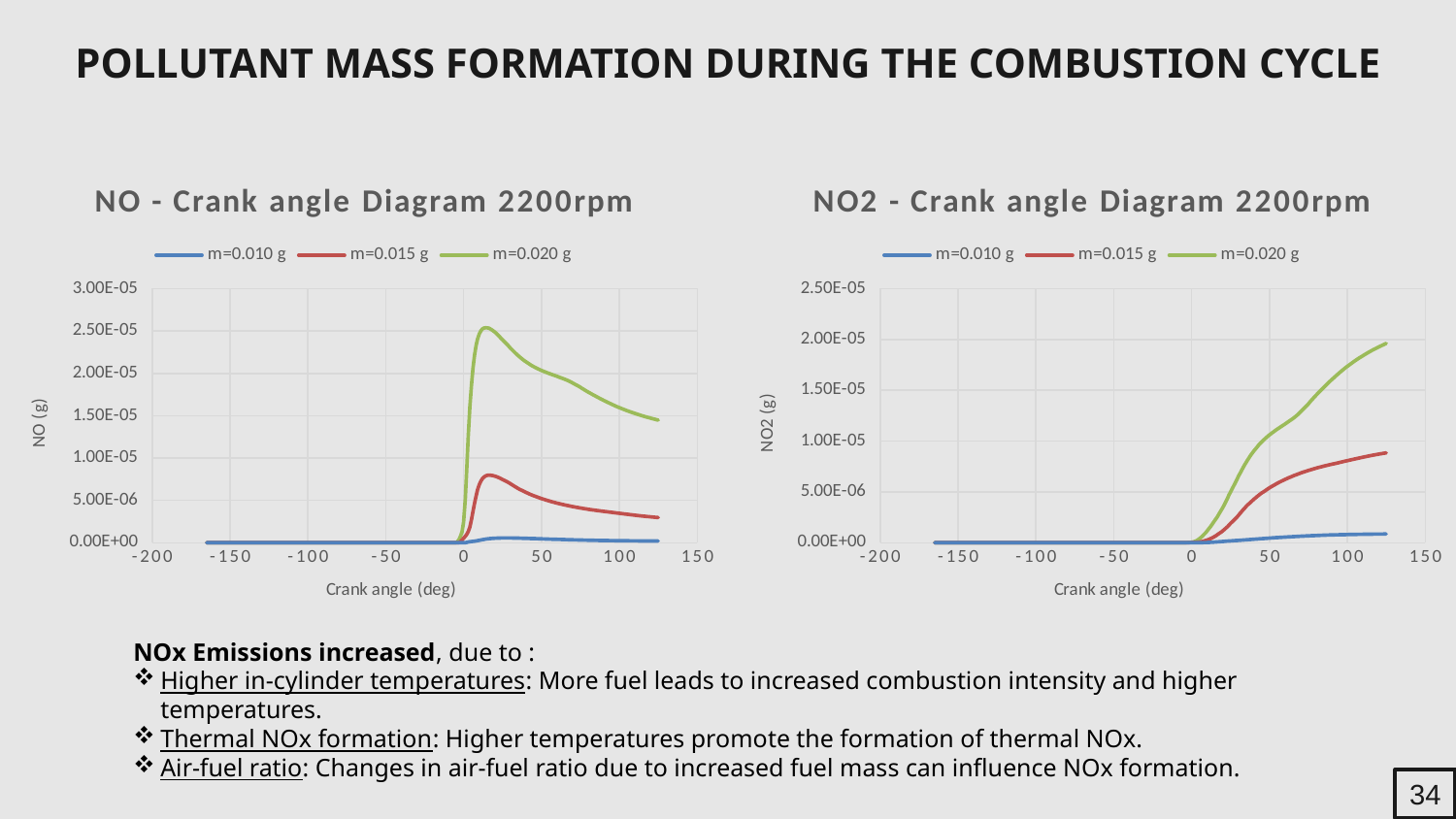
In the 'NO2 - Crank angle Diagram 2200rpm' chart, which series is higher at a crank angle of 100: m=0.015 g or m=0.020 g? m=0.020 g In the 'NO - Crank angle Diagram 2200rpm' chart, is the peak value of the m=0.015 g series greater or less than 1.00E-05? less In the 'NO - Crank angle Diagram 2200rpm' chart, which series reaches the highest NO value? m=0.020 g In the 'NO - Crank angle Diagram 2200rpm' chart, does the m=0.020 g series rise or fall between crank angles of 50 and 125? fall In the 'NO2 - Crank angle Diagram 2200rpm' chart, does the m=0.020 g series rise or fall as the crank angle increases from 0 to 125? rise In the 'NO2 - Crank angle Diagram 2200rpm' chart, is the value of the m=0.015 g series at the right end of the curve greater or less than 1.00E-05? less In the 'NO2 - Crank angle Diagram 2200rpm' chart, which series has the lowest NO2 values? m=0.010 g What kind of chart is the 'NO - Crank angle Diagram 2200rpm' chart? line chart In the 'NO2 - Crank angle Diagram 2200rpm' chart, is the value of the m=0.020 g series at the right end of the curve greater or less than 1.50E-05? greater How many series does the legend of the 'NO2 - Crank angle Diagram 2200rpm' chart list? 3 What is the x-axis label of the 'NO - Crank angle Diagram 2200rpm' chart? Crank angle (deg)